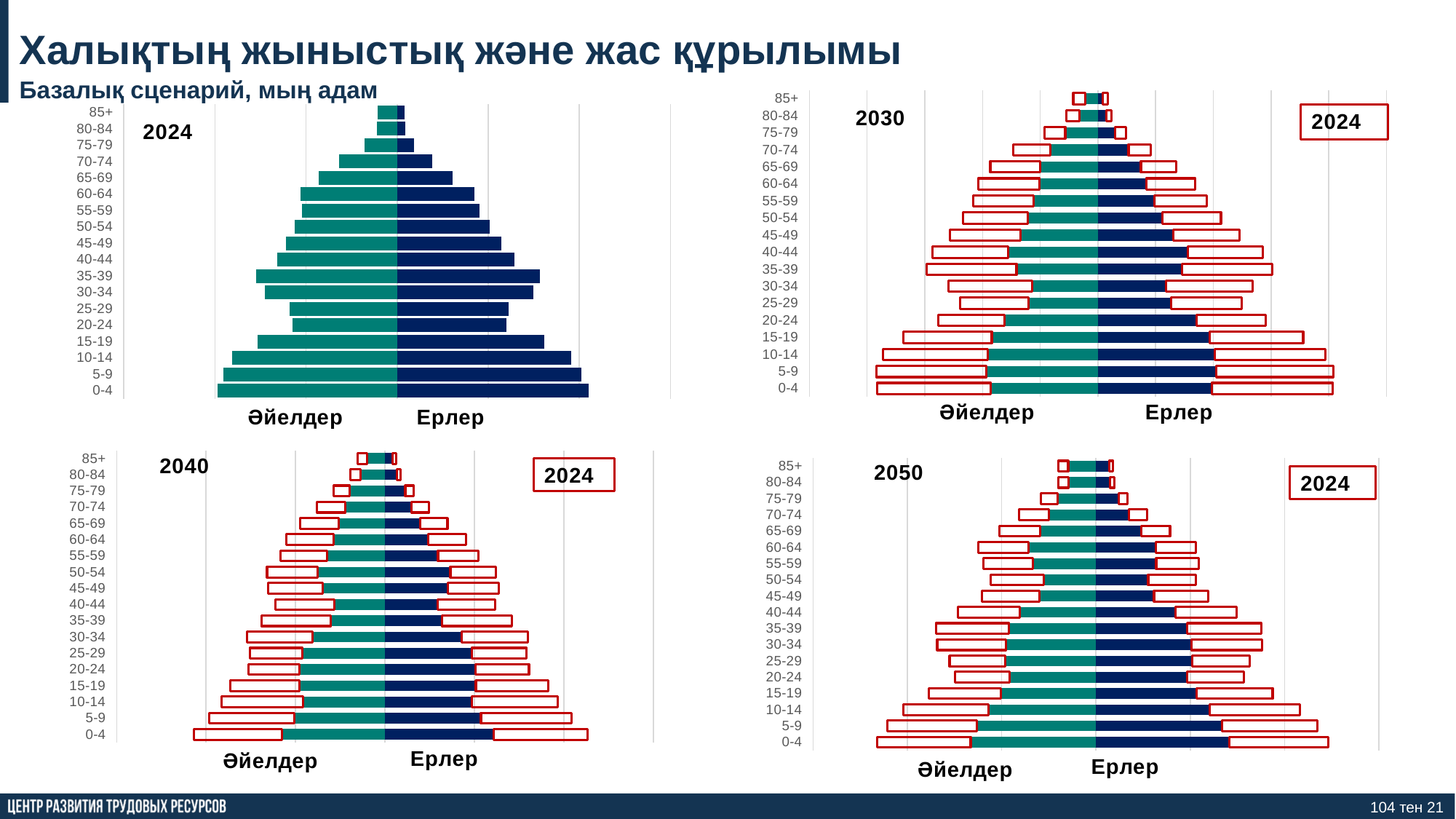
In the 2024 chart, which age group is larger for Әйелдер: 10-14 or 20-24? 10-14 How many series does the 2024 chart show (as labelled below it)? 2 In the 2030 chart, what do the red outlined bars represent, according to the box in the corner? 2024 How many age groups are listed on the vertical axis of the 2024 chart? 18 What are the two series labelled below the 2024 chart? Әйелдер and Ерлер In the 2024 chart, do the bars generally get shorter or longer moving from the 0-4 group up to the 85+ group? Shorter In the 2040 chart, which age group is larger for Әйелдер: 0-4 or 60-64? 0-4 In the 2050 chart, which age group is larger for Ерлер: 0-4 or 70-74? 0-4 What kind of chart is the top-left chart labelled 2024? Bar chart (population pyramid) Which age group is at the top of the vertical axis in each chart? 85+